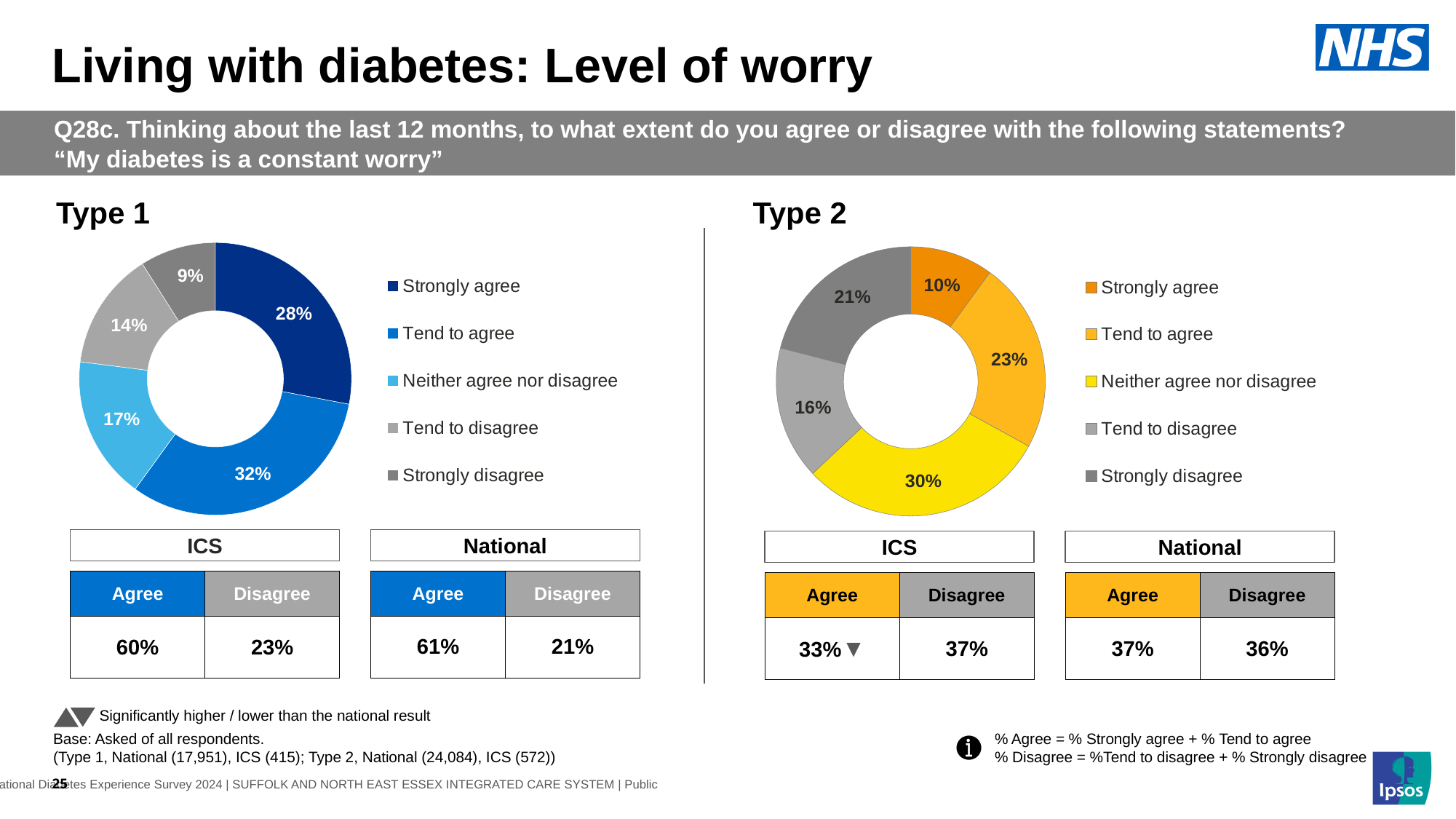
How many response categories does the legend of the Type 2 chart list? 5 In the Type 1 chart, which response category has the largest share? Tend to agree In the Type 1 chart, what percentage of respondents said they tend to agree? 32% In the Type 2 chart, what percentage of respondents said they neither agree nor disagree? 30% In the Type 1 chart, which is larger: the Tend to disagree share or the Neither agree nor disagree share? Neither agree nor disagree In the Type 2 chart, which response category has the smallest share? Strongly agree In the Type 2 chart, what is the difference between the Neither agree nor disagree share and the Tend to agree share? 7 percentage points In the Type 1 chart, which response category has the smallest share? Strongly disagree In the Type 1 chart, what percentage of respondents said they strongly agree? 28% In the Type 2 chart, what percentage of respondents said they strongly disagree? 21% In the Type 1 chart, what colour represents Strongly agree? Dark blue What kind of chart is used for the Type 1 data? Doughnut (pie) chart